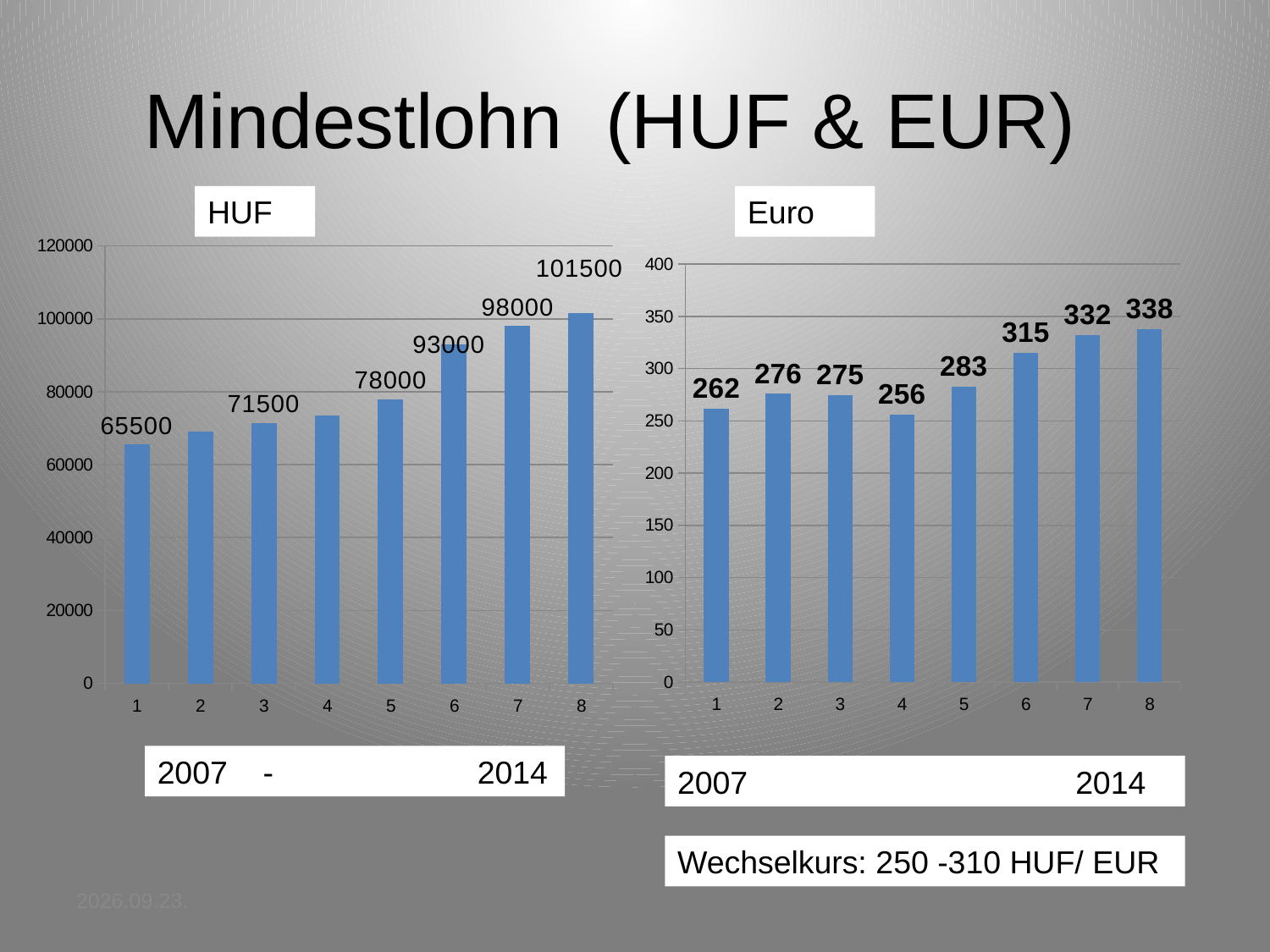
In the Euro chart, what is the value for category 4? 256 In the Euro chart, what is the value for category 6? 315 In the Euro chart, which category has the lowest value? 4 In the Euro chart, what is the difference between the values for category 8 and category 1? 76 In the HUF chart, what is the difference between the values for category 8 and category 7? 3500 In the HUF chart, is the value for category 2 greater or less than 80000? less In the Euro chart, which category has the highest value? 8 In the HUF chart, what is the value for category 8? 101500 What type of chart is the Euro chart? bar chart In the HUF chart, what is the value for category 1? 65500 In the Euro chart, which is larger, the value for category 2 or category 3? category 2 How many bars does the HUF chart show? 8